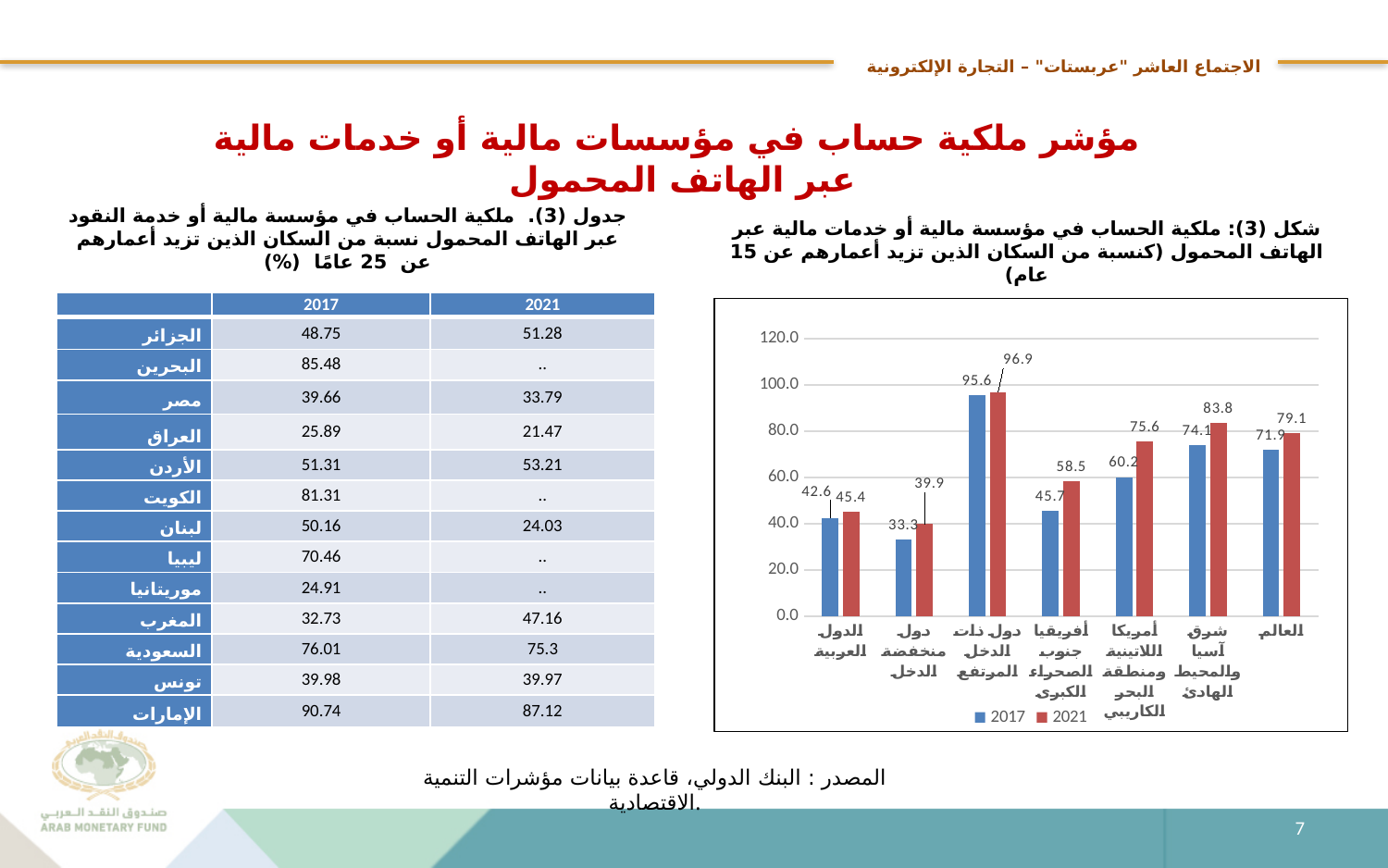
What is the 2021 value for العالم in the chart? 79.1 How many categories are shown on the x axis of the chart? 7 Which legend entry is shown in red in the chart? 2021 What is the difference between the 2021 and 2017 values for أمريكا اللاتينية ومنطقة البحر الكاريبي? 15.4 Which category has the highest 2021 value in the chart? دول ذات الدخل المرتفع Is the 2017 value for دول ذات الدخل المرتفع greater or less than 80.0? greater Which is larger in the chart: the 2021 value for شرق آسيا والمحيط الهادئ or the 2021 value for العالم? شرق آسيا والمحيط الهادئ What is the 2017 value for الدول العربية in the chart? 42.6 What type of chart is shown on the slide? Bar chart How many series does the chart legend list? 2 What is the 2021 value for أفريقيا جنوب الصحراء الكبرى in the chart? 58.5 Which category has the lowest 2017 value in the chart? دول منخفضة الدخل